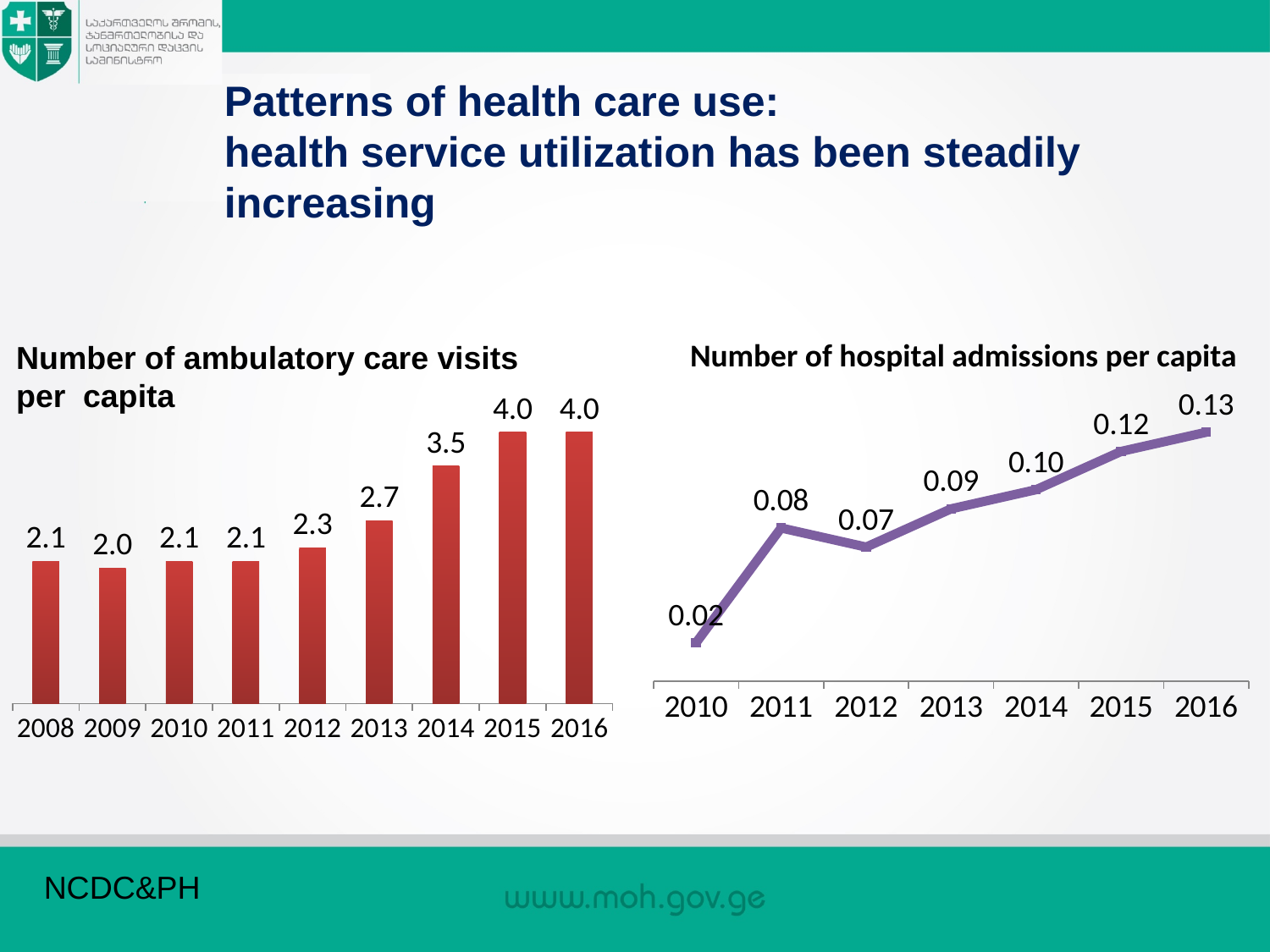
In the 'Number of hospital admissions per capita' chart, which year has the highest value? 2016 In the 'Number of ambulatory care visits per capita' chart, how many years are shown on the x axis? 9 In the 'Number of hospital admissions per capita' chart, what is the value for 2013? 0.09 In the 'Number of ambulatory care visits per capita' chart, which year has the lowest value? 2009 In the 'Number of ambulatory care visits per capita' chart, what is the difference between the 2016 value and the 2008 value? 1.9 In the 'Number of hospital admissions per capita' chart, what is the difference between the 2016 value and the 2010 value? 0.11 In the 'Number of hospital admissions per capita' chart, which is larger, the value for 2011 or the value for 2012? 2011 In the 'Number of ambulatory care visits per capita' chart, what is the value for 2014? 3.5 What kind of chart is the 'Number of ambulatory care visits per capita' chart? Bar chart In the 'Number of ambulatory care visits per capita' chart, what is the value for 2012? 2.3 In the 'Number of hospital admissions per capita' chart, do the values generally rise or fall from 2010 to 2016? Rise What kind of chart is the 'Number of hospital admissions per capita' chart? Line chart